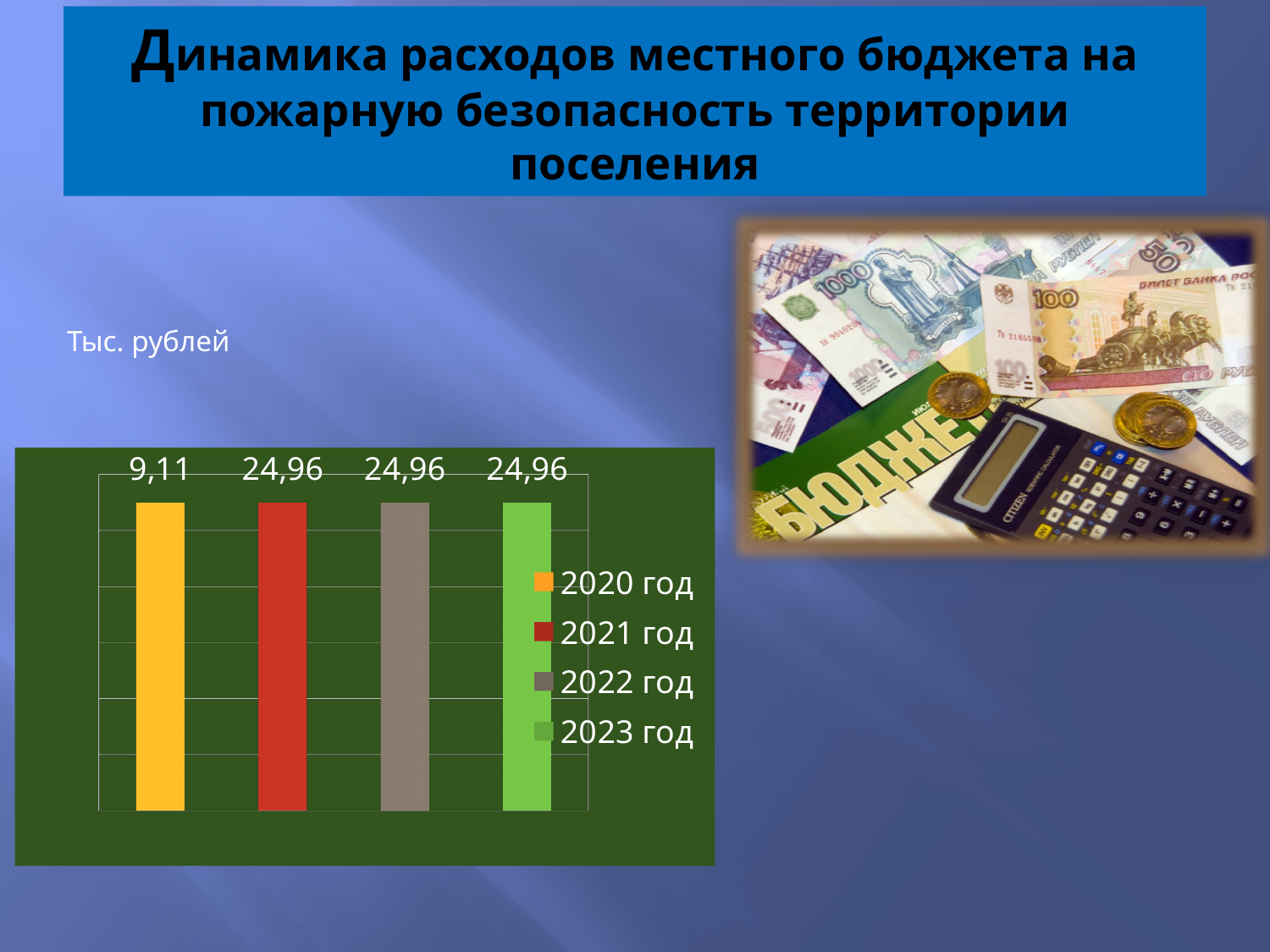
What unit is stated above the chart? Тыс. рублей What kind of chart is shown on the slide? bar chart What colour is the bar for 2021 год? red What is the value for 2021 год? 24,96 How many bars are plotted in the chart? 4 Which is larger, the value for 2020 год or the value for 2022 год? 2022 год What is the value for 2023 год? 24,96 How many entries does the legend list? 4 What is the difference between the values for 2021 год and 2020 год? 15,85 Which year has the lowest value? 2020 год What is the value for 2020 год? 9,11